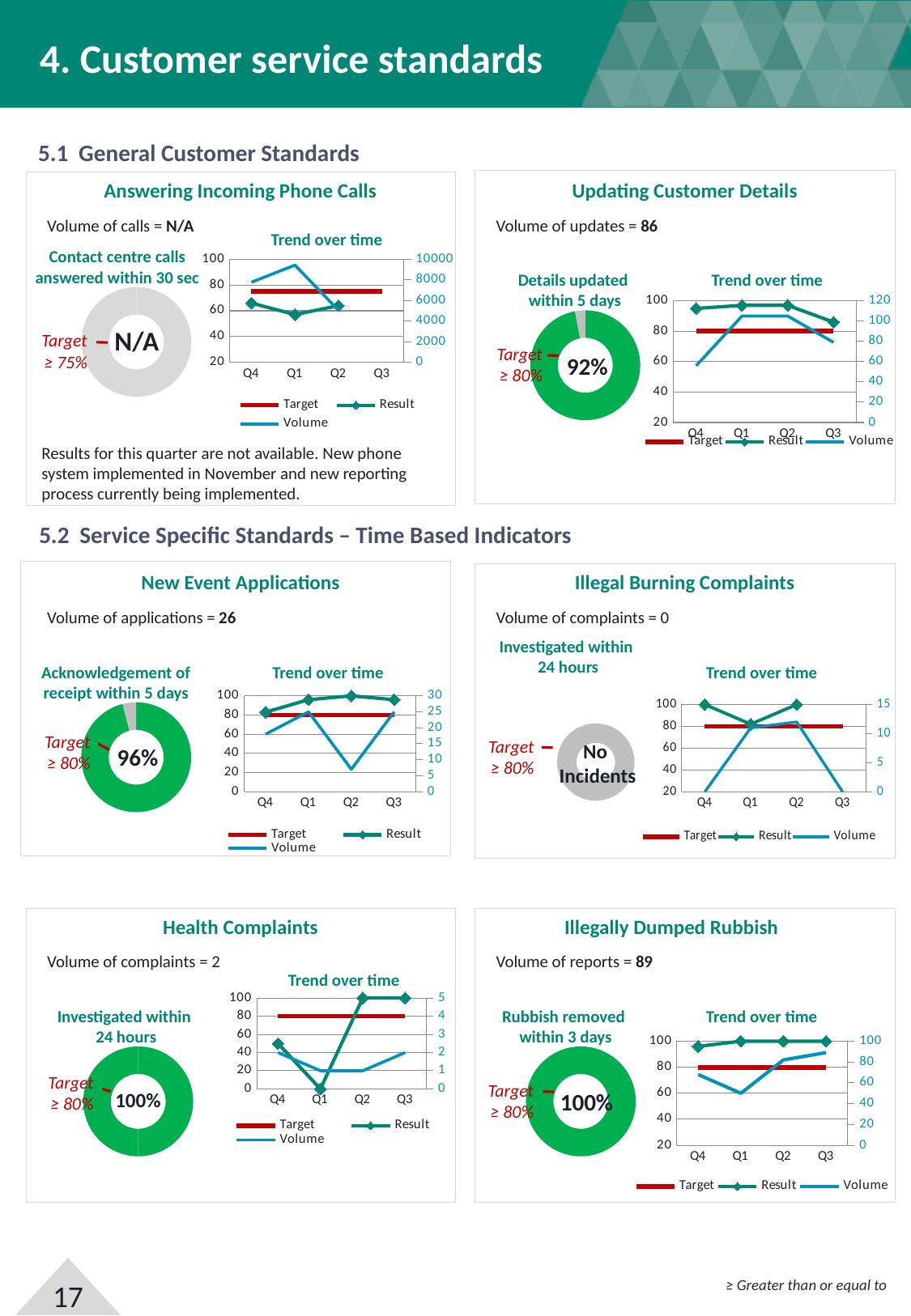
On the Illegal Burning Complaints 'Trend over time' chart, is the Result value for Q4 greater or less than 80? greater On the Answering Incoming Phone Calls panel, what value is shown in the centre of the donut chart? N/A On the Updating Customer Details panel, what percentage is shown in the 'Details updated within 5 days' donut chart? 92% On the Health Complaints 'Trend over time' chart, in which quarter is the Result value lowest? Q1 What kind of chart is the 'Trend over time' chart on the Illegally Dumped Rubbish panel? line chart On the Answering Incoming Phone Calls panel, what target is stated next to the donut chart? ≥ 75% On the Health Complaints 'Trend over time' chart, is the Result value for Q1 greater or less than 20? less How many quarters are shown on the x axis of the New Event Applications 'Trend over time' chart? 4 On the Health Complaints 'Trend over time' chart, which is larger: the Result value for Q1 or the Result value for Q2? Q2 On the Health Complaints panel, what percentage is shown in the 'Investigated within 24 hours' donut chart? 100% On the New Event Applications panel, what percentage is shown in the 'Acknowledgement of receipt within 5 days' donut chart? 96% How many series does the legend of the Health Complaints 'Trend over time' chart list? 3